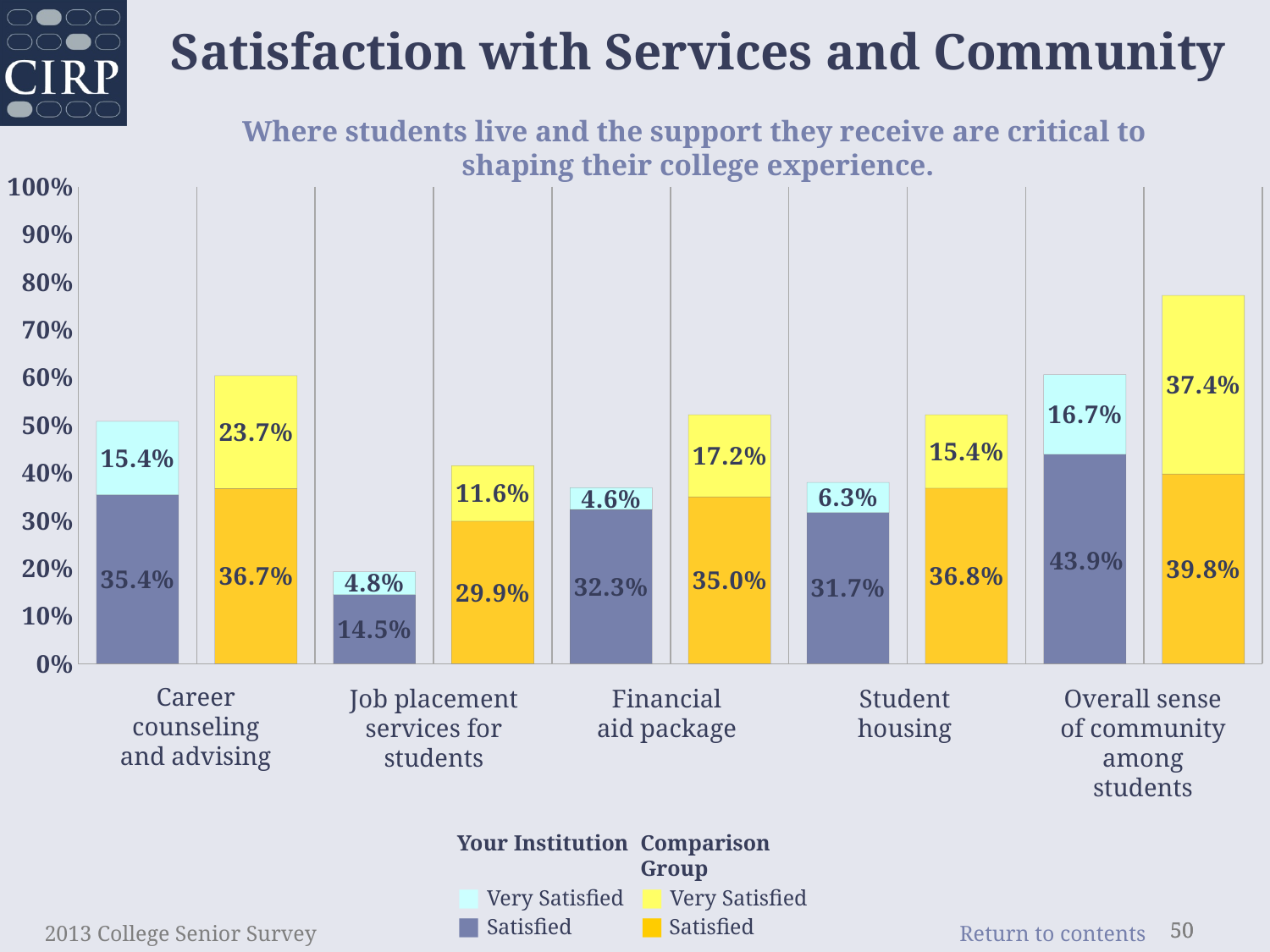
Which category has the lowest Satisfied percentage for Your Institution? Job placement services for students Which category has the highest Very Satisfied percentage for Your Institution? Overall sense of community among students What kind of chart is shown on the slide? Stacked bar chart What percentage of students at Your Institution were Very Satisfied with job placement services for students? 4.8% How many series does the legend list? 4 What is the total (Satisfied plus Very Satisfied) for Your Institution on overall sense of community among students? 60.6% For student housing, which is larger: the Satisfied percentage for Your Institution or for the Comparison Group? Comparison Group How many service/community categories are shown on the x axis? 5 What percentage of the Comparison Group were Very Satisfied with the overall sense of community among students? 37.4% What is the total (Satisfied plus Very Satisfied) for the Comparison Group on job placement services for students? 41.5% What is the difference between the Comparison Group's Very Satisfied percentage and Your Institution's Very Satisfied percentage for financial aid package? 12.6% What percentage of students at Your Institution were Satisfied with career counseling and advising? 35.4%